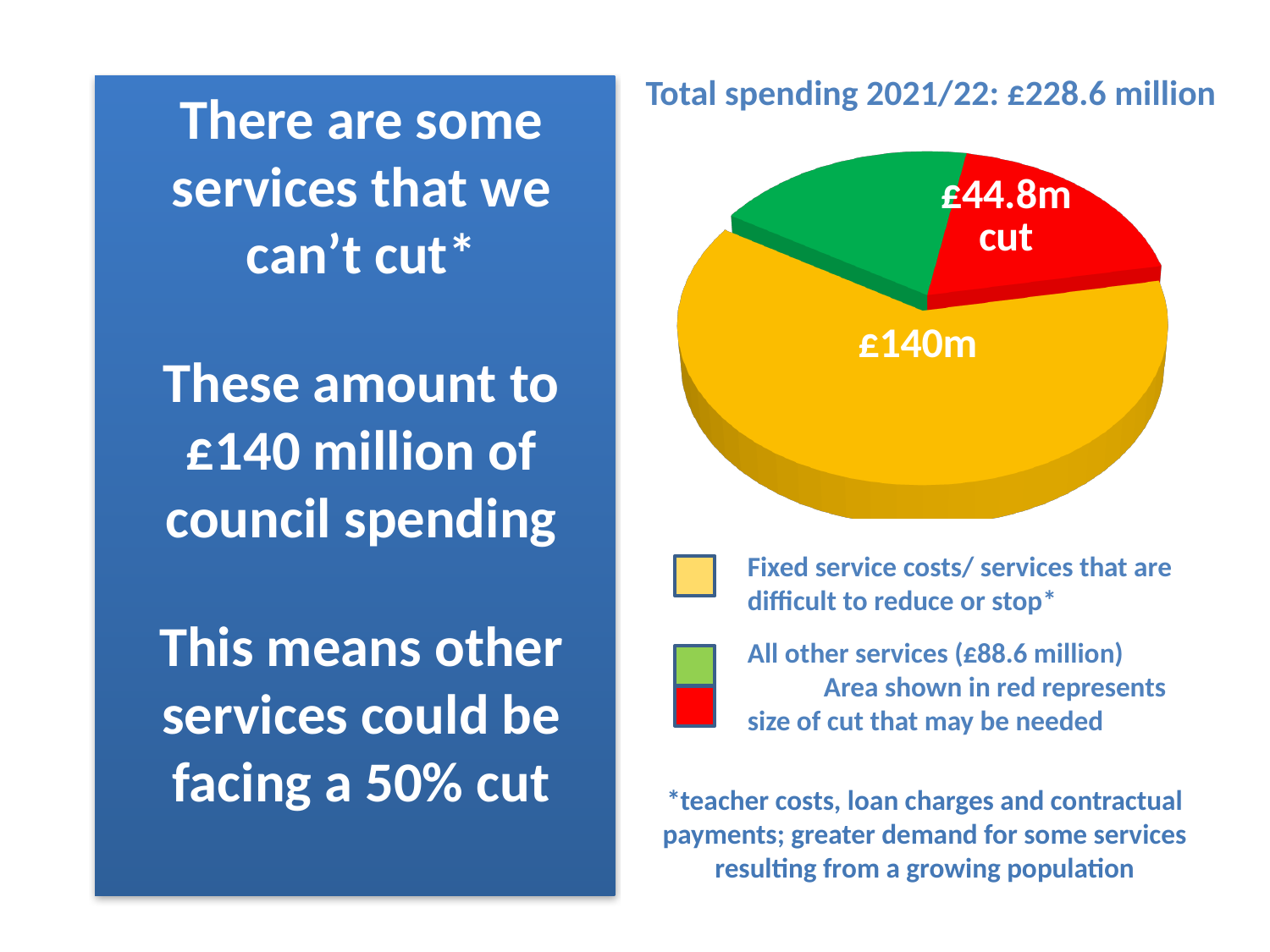
What kind of chart is shown on the slide? pie chart According to the legend, what does the red area of the pie chart represent? size of cut that may be needed What value is labelled on the red slice of the pie chart? £44.8m Which is larger, the yellow slice or the red slice? the yellow slice Which slice of the pie chart is the largest? Fixed service costs/ services that are difficult to reduce or stop (£140m) What is the title of the chart? Total spending 2021/22: £228.6 million What value is labelled on the yellow slice of the pie chart? £140m What is the difference between the £140m slice and the £44.8m cut slice? £95.2m How many slices does the pie chart have? 3 According to the legend, what is the total for all other services? £88.6 million